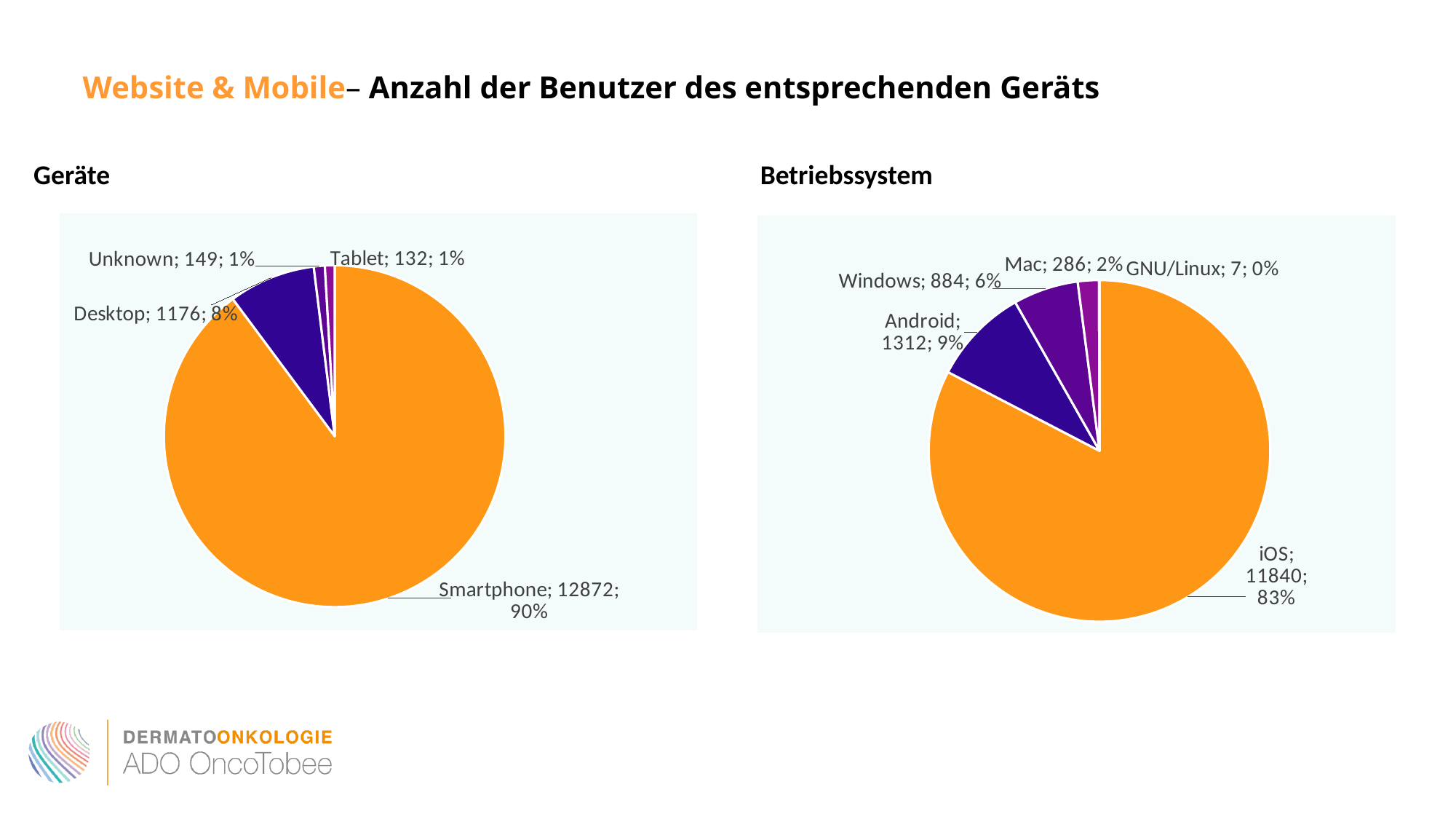
In the Betriebssystem chart, how many categories are shown? 5 In the Betriebssystem chart, what share of the pie does iOS have? 83% In the Betriebssystem chart, which has more users, Windows or Mac? Windows In the Betriebssystem chart, how many users are shown for Android? 1312 In the Betriebssystem chart, what is the difference in users between Android and Windows? 428 In the Geräte chart, which category has the smallest number of users? Tablet In the Geräte chart, what is the difference in users between Desktop and Unknown? 1027 In the Betriebssystem chart, which category has the fewest users? GNU/Linux In the Geräte chart, how many users are shown for Smartphone? 12872 What kind of chart is the Geräte chart? Pie chart In the Geräte chart, how many categories are shown? 4 In the Geräte chart, what share of the pie does Desktop have? 8%